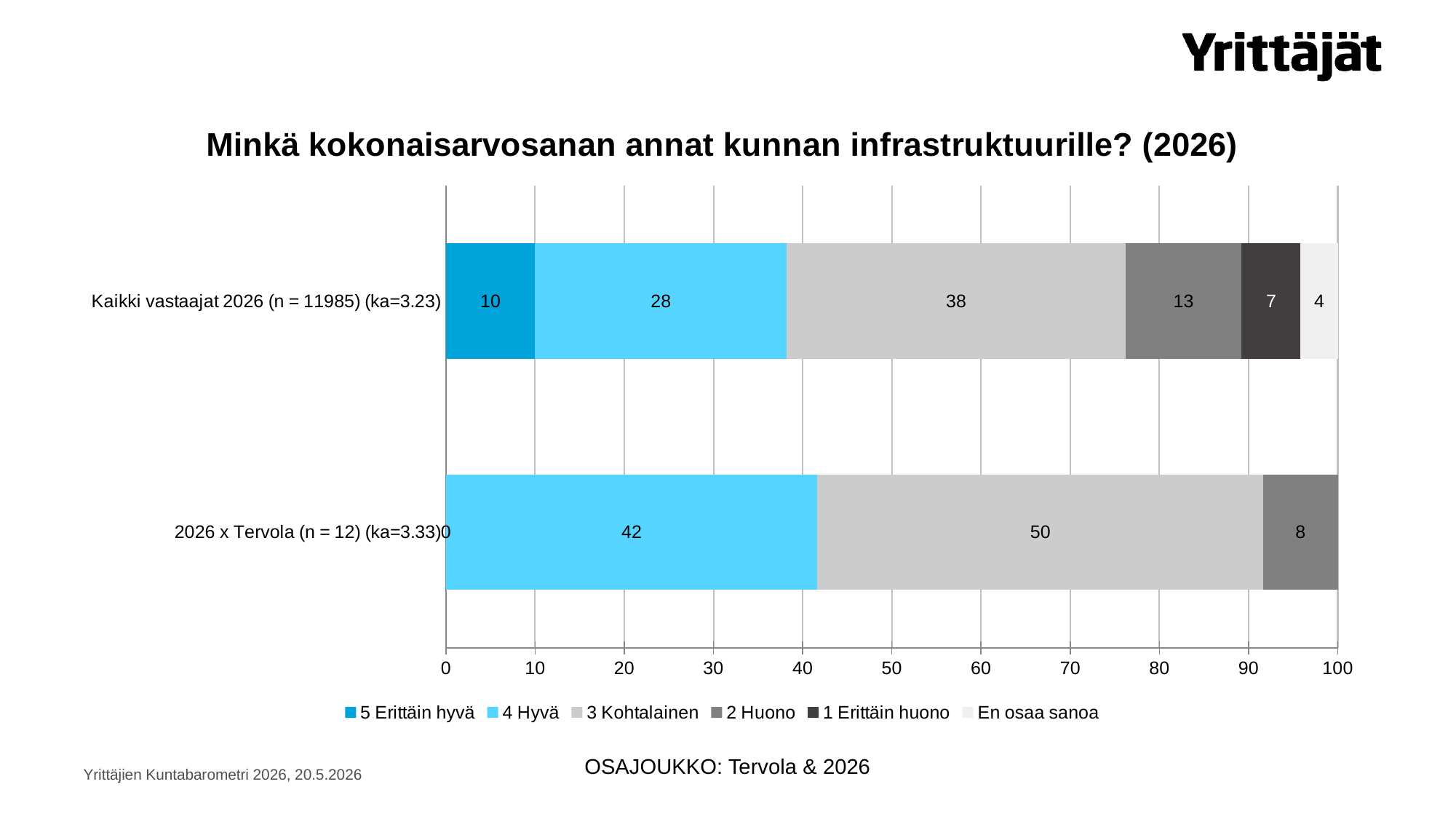
How many series does the legend list? 6 What is the value of "3 Kohtalainen" for "Kaikki vastaajat 2026 (n = 11985) (ka=3.23)"? 38 What is the value of "1 Erittäin huono" for "Kaikki vastaajat 2026 (n = 11985) (ka=3.23)"? 7 What is the title of the chart? Minkä kokonaisarvosanan annat kunnan infrastruktuurille? (2026) Which series has the highest value for "2026 x Tervola (n = 12) (ka=3.33)"? 3 Kohtalainen Which is larger: "3 Kohtalainen" for "Kaikki vastaajat 2026 (n = 11985) (ka=3.23)" or for "2026 x Tervola (n = 12) (ka=3.33)"? 2026 x Tervola (n = 12) (ka=3.33) What kind of chart is shown on the slide? Stacked bar chart Which series has the lowest value for "Kaikki vastaajat 2026 (n = 11985) (ka=3.23)"? En osaa sanoa What is the value of "4 Hyvä" for "2026 x Tervola (n = 12) (ka=3.33)"? 42 What is the difference between the "4 Hyvä" values for "2026 x Tervola (n = 12) (ka=3.33)" and "Kaikki vastaajat 2026 (n = 11985) (ka=3.23)"? 14 How many categories (bars) are shown in the chart? 2 What is the value of "2 Huono" for "2026 x Tervola (n = 12) (ka=3.33)"? 8